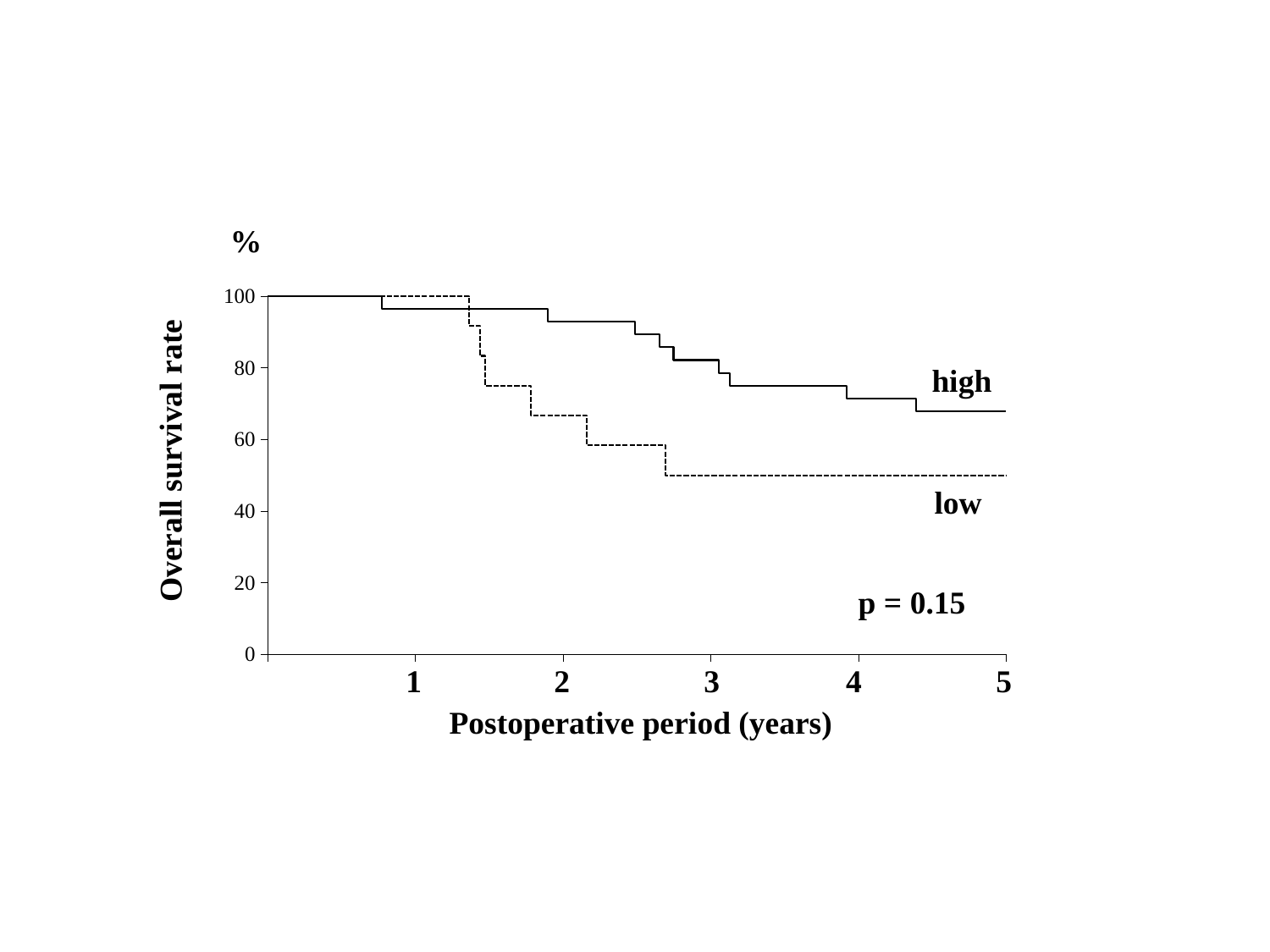
Which group has the lower overall survival rate at 3 years? low What is the overall survival rate for the low group at 1 year? 100 Is the overall survival rate for the high group at 4 years greater or less than 80? less What are the names of the two groups plotted on the chart? high and low What kind of chart is shown on the slide? line chart Is the overall survival rate for the low group at 4 years greater or less than 40? greater Which group has the higher overall survival rate at 5 years, high or low? high How many series (groups) are plotted on the chart? 2 Do the overall survival rates rise or fall as the postoperative period increases? fall Is the overall survival rate for the low group at 5 years greater or less than 60? less What is the label of the x axis? Postoperative period (years)